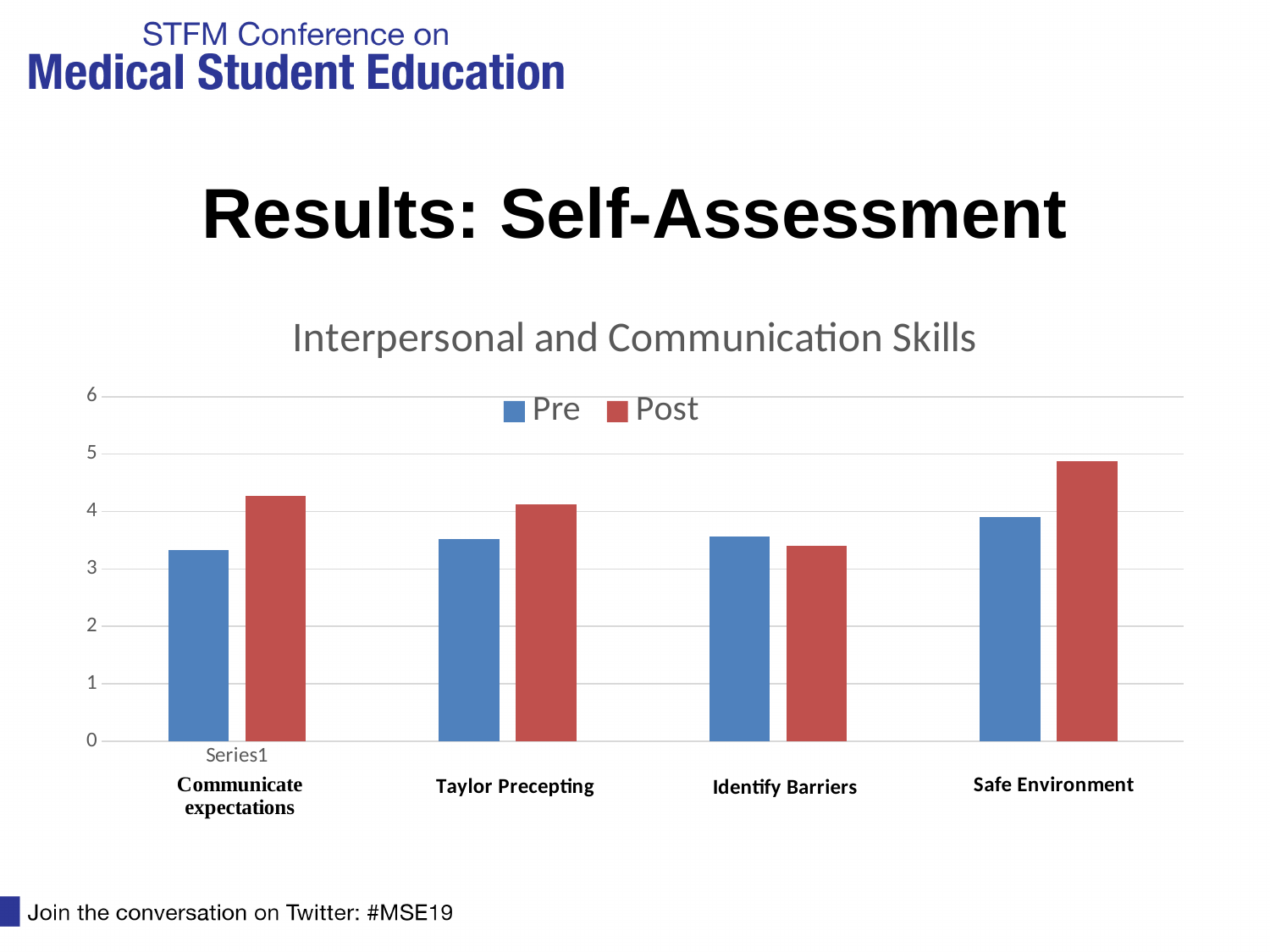
Is the Pre value for Communicate expectations greater or less than 4? less Is the Post value for Safe Environment greater or less than 4? greater How many series does the legend list? 2 What is the title of the chart? Interpersonal and Communication Skills For Communicate expectations, which is larger, the Pre value or the Post value? Post What kind of chart is shown on the slide? bar chart Which category has the highest Pre value? Safe Environment For Identify Barriers, which is larger, the Pre value or the Post value? Pre How many categories are shown on the x axis? 4 Which category has the lowest Pre value? Communicate expectations Which category has the lowest Post value? Identify Barriers Which category has the highest Post value? Safe Environment